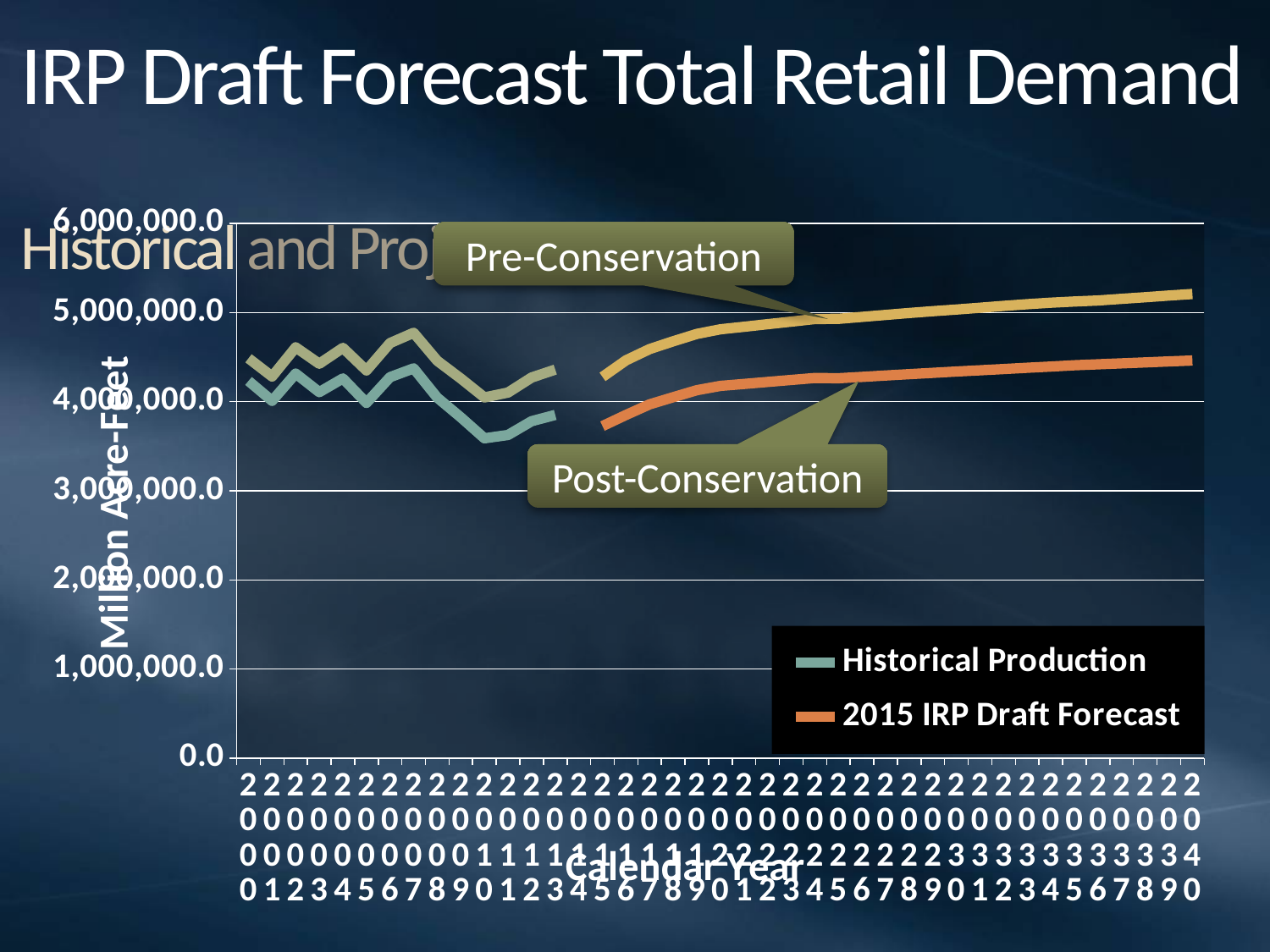
What kind of chart is shown on the slide? line chart What is the title of the vertical axis? Million Acre-Feet Which forecast line is higher in 2040, Pre-Conservation or Post-Conservation? Pre-Conservation Do the 2015 IRP Draft Forecast lines rise or fall from 2015 to 2040? rise Is the lower Historical Production line's value for 2012 greater or less than 4,000,000.0? less How many calendar years are shown along the x axis? 41 How many series does the chart legend list? 2 Which line reaches the highest value on the chart? Pre-Conservation Is the Post-Conservation forecast value for 2040 greater or less than 5,000,000.0? less What are the two series named in the legend? Historical Production and 2015 IRP Draft Forecast Is the Pre-Conservation forecast value for 2040 greater or less than 5,000,000.0? greater